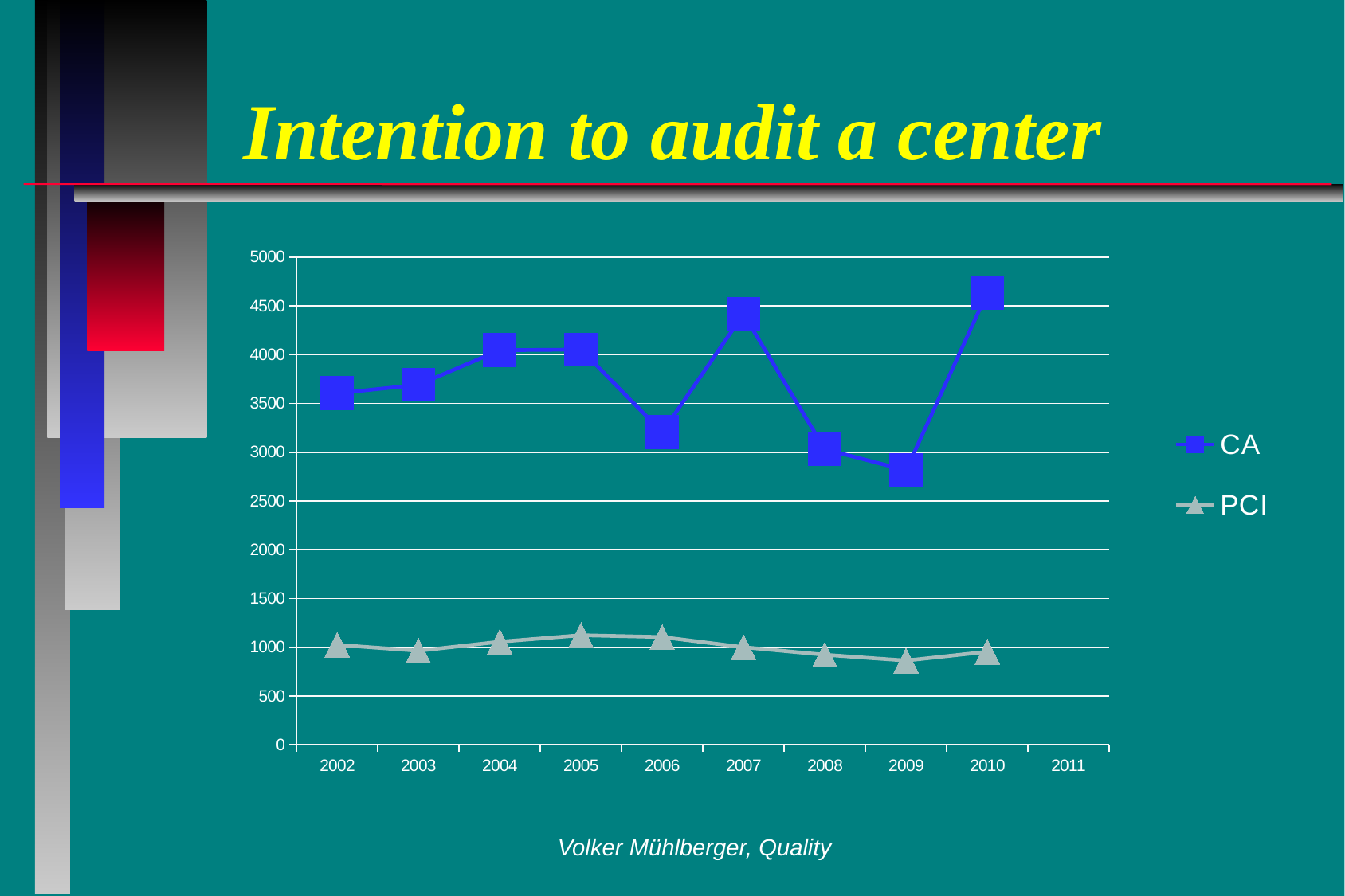
Which series are listed in the legend? CA and PCI Is the CA value for 2009 greater or less than 3000? less In which year does the CA series reach its lowest value? 2009 In which year does the CA series reach its highest value? 2010 Which is larger, the CA value for 2006 or the CA value for 2007? 2007 Is the CA value for 2007 greater or less than 4000? greater Is the CA value for 2010 greater or less than 4500? greater What kind of chart is shown on the slide? line chart How many year labels are shown on the x axis? 10 How many series does the legend list? 2 Does the CA series rise or fall from 2007 to 2009? fall